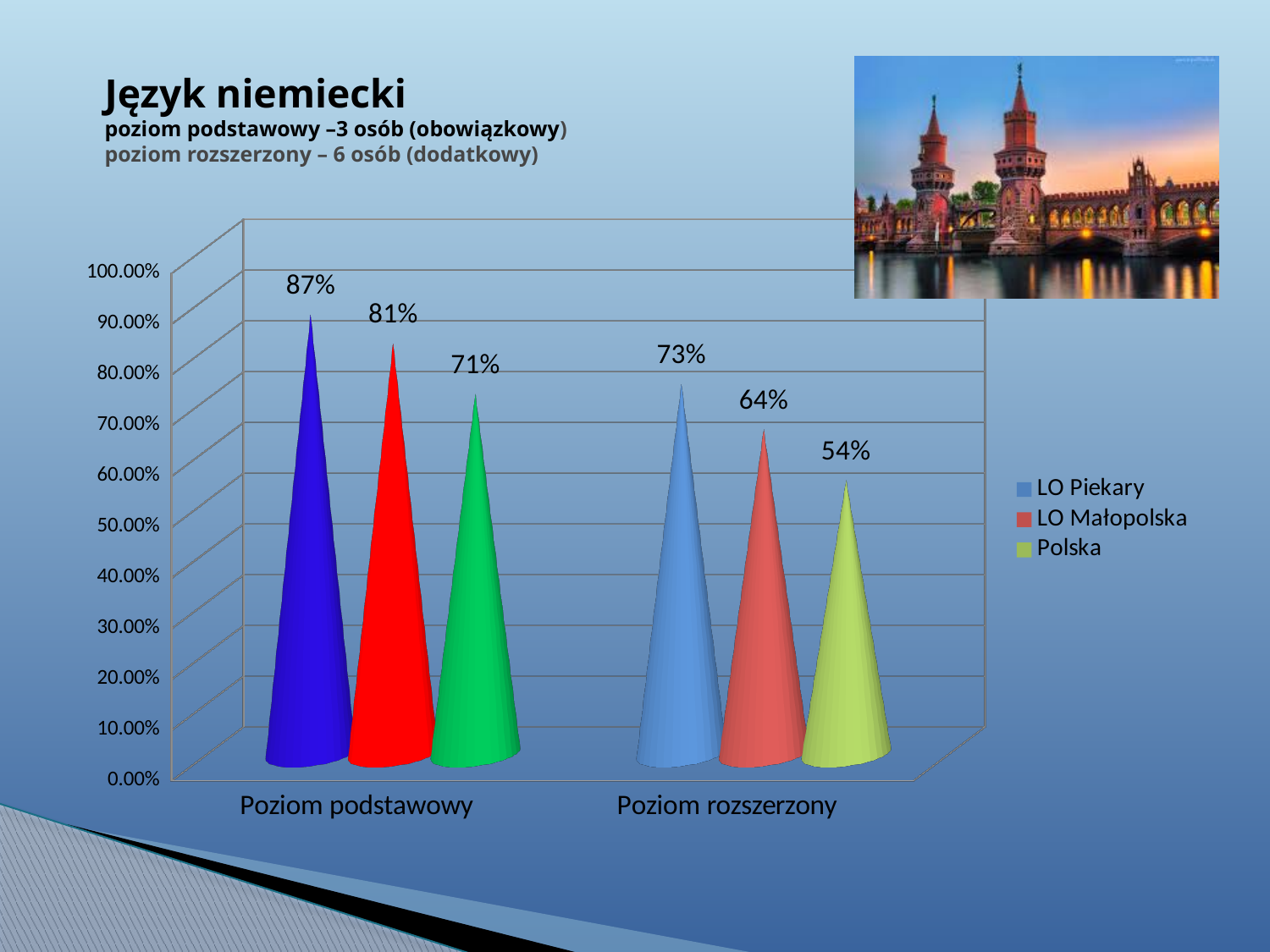
What kind of chart is shown on the slide? Bar chart What is the value for Polska at Poziom rozszerzony? 54% What is the value for LO Piekary at Poziom podstawowy? 87% What is the value for LO Małopolska at Poziom rozszerzony? 64% How many series does the legend list? 3 Which series has the lowest value at Poziom rozszerzony? Polska Which series has the highest value at Poziom podstawowy? LO Piekary Which is larger: LO Małopolska at Poziom podstawowy or LO Piekary at Poziom rozszerzony? LO Małopolska at Poziom podstawowy What is the difference between LO Piekary's values at Poziom podstawowy and Poziom rozszerzony? 14% Do the values for Polska rise or fall from Poziom podstawowy to Poziom rozszerzony? Fall What is the difference between LO Piekary and Polska at Poziom podstawowy? 16% How many categories are shown on the x axis? 2